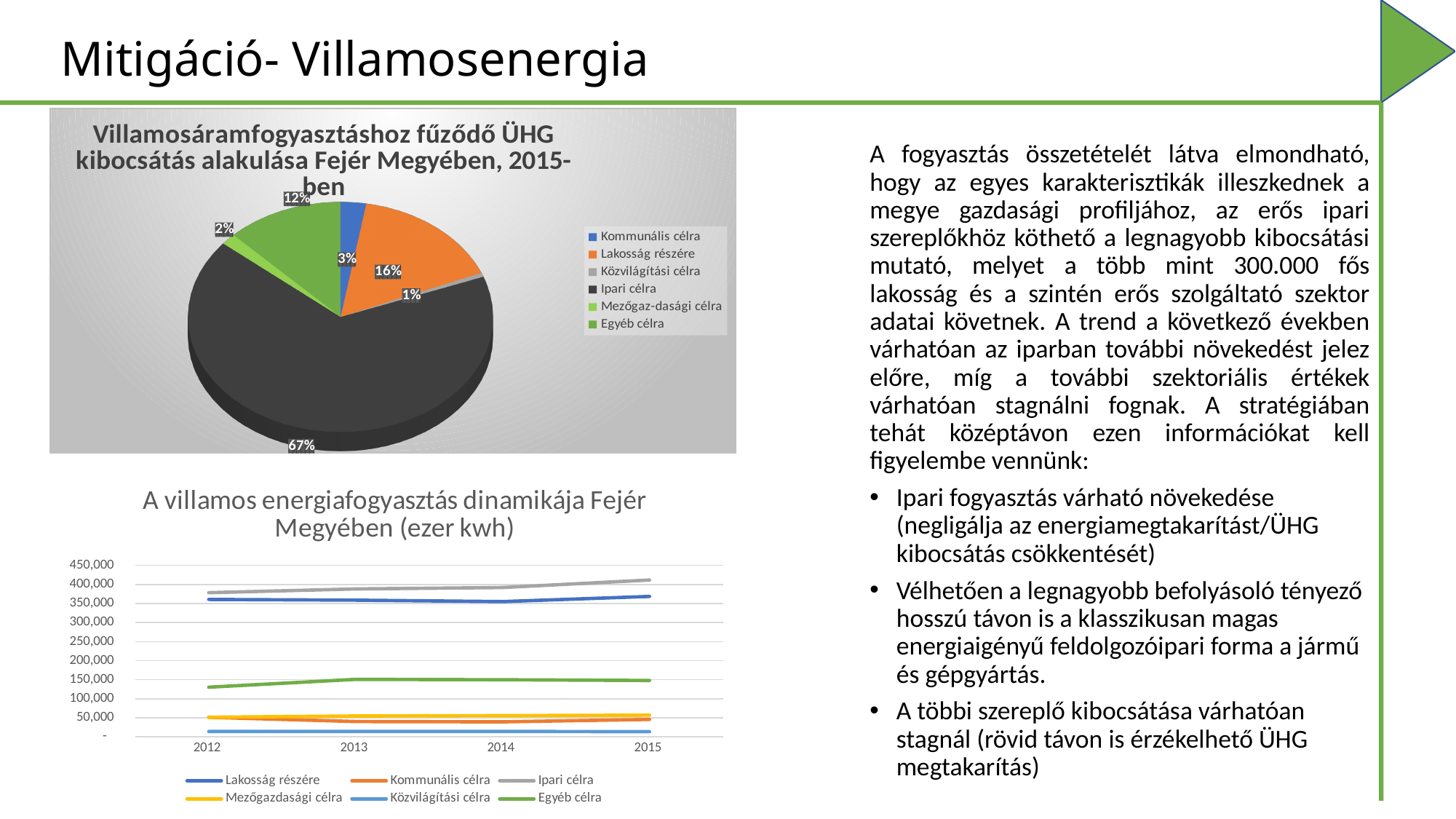
What type of chart is the bottom chart on the slide? Line chart In the pie chart, what share of emissions is attributed to Ipari célra? 67% In the pie chart, what is the difference in percentage points between Lakosság részére and Egyéb célra? 4 In the pie chart, which category has the smallest share? Közvilágítási célra In the bottom line chart, how many series does the legend list? 6 In the pie chart, what percentage is shown for Lakosság részére? 16% In the pie chart, which category has the largest share? Ipari célra In the bottom line chart, is the value for Egyéb célra in 2015 greater or less than 100,000? greater In the pie chart, what percentage is shown for Egyéb célra? 12% In the bottom line chart, which series has the higher value in 2015: Ipari célra or Lakosság részére? Ipari célra In the bottom line chart, does the value for Ipari célra rise or fall from 2012 to 2015? rise In the pie chart, how many categories does the legend list? 6